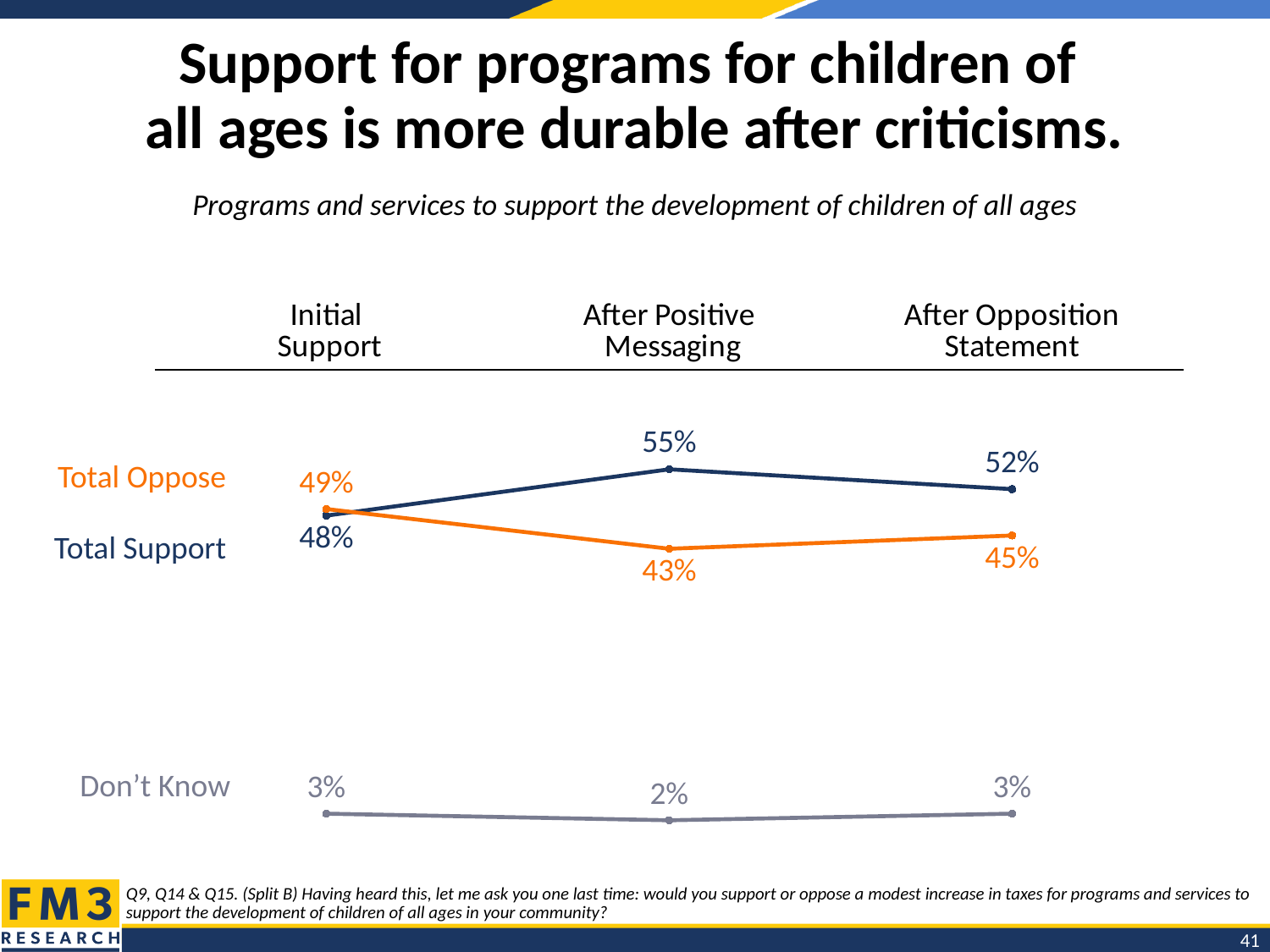
What is the Total Support value after positive messaging? 55% What is the Don't Know value after positive messaging? 2% Does Total Oppose rise or fall from the initial support stage to after positive messaging? fall What is the difference between Total Support and Total Oppose after the opposition statement? 7 percentage points Which is larger after positive messaging, Total Support or Total Oppose? Total Support What is the Total Support value after the opposition statement? 52% How many stages are shown along the x axis? 3 At which stage is Total Support highest? After Positive Messaging What type of chart is shown on the slide? line chart How many series are plotted on the chart? 3 At which stage is Total Oppose lowest? After Positive Messaging What is the Total Oppose value at the initial support stage? 49%